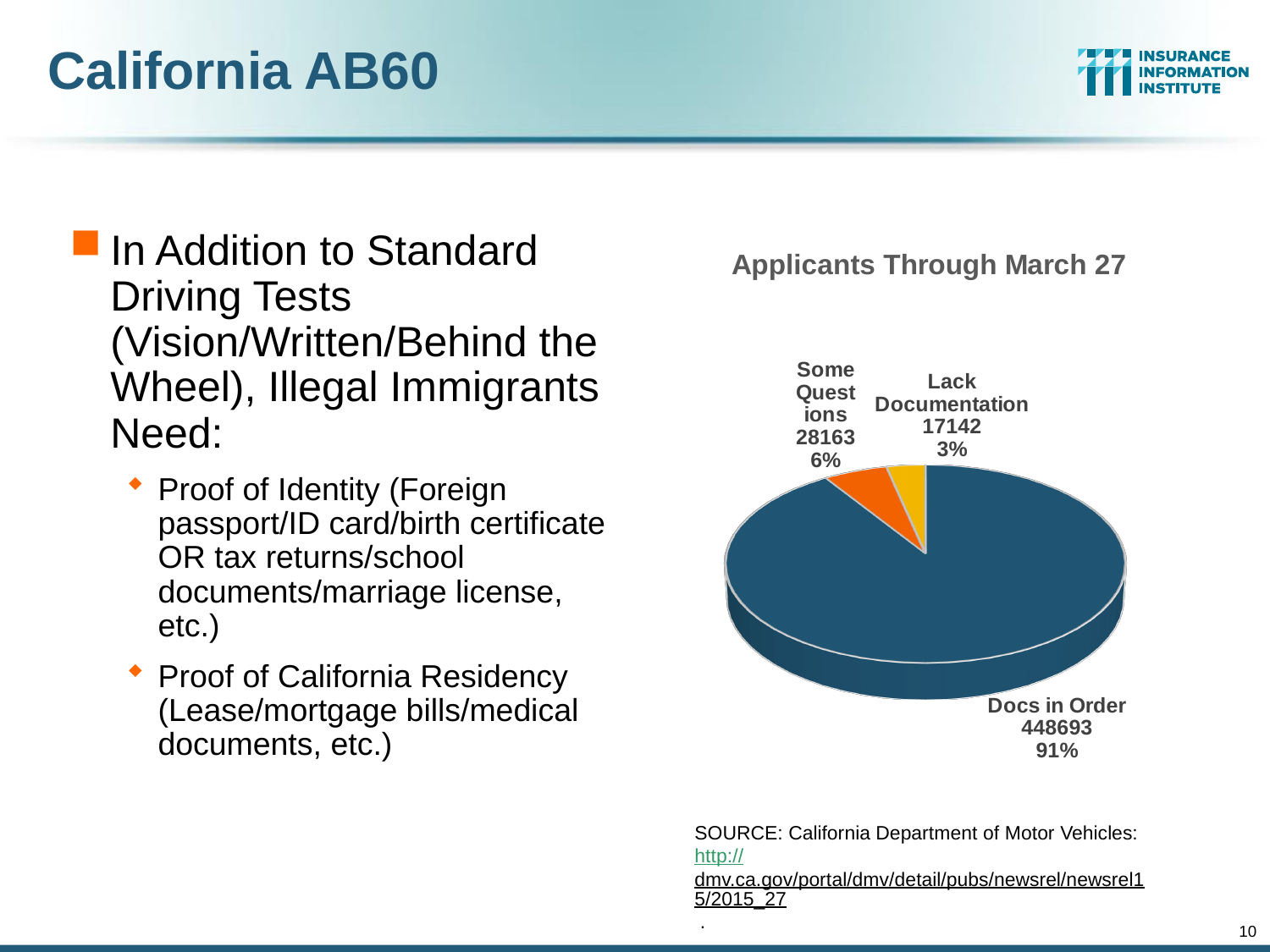
Which category has the smallest slice of the pie? Lack Documentation How many slices does the pie chart have? 3 How many applicants are in the "Lack Documentation" category? 17142 How many applicants are in the "Docs in Order" category? 448693 What kind of chart is shown on the slide? pie chart What is the title of the pie chart? Applicants Through March 27 Which is larger, the number of applicants with "Some Questions" or those that "Lack Documentation"? Some Questions Which category has the largest slice of the pie? Docs in Order How many applicants are in the "Some Questions" category? 28163 What is the difference between the number of applicants with "Some Questions" and those that "Lack Documentation"? 11021 What share of the pie does "Docs in Order" represent? 91% What share of the pie does "Lack Documentation" represent? 3%